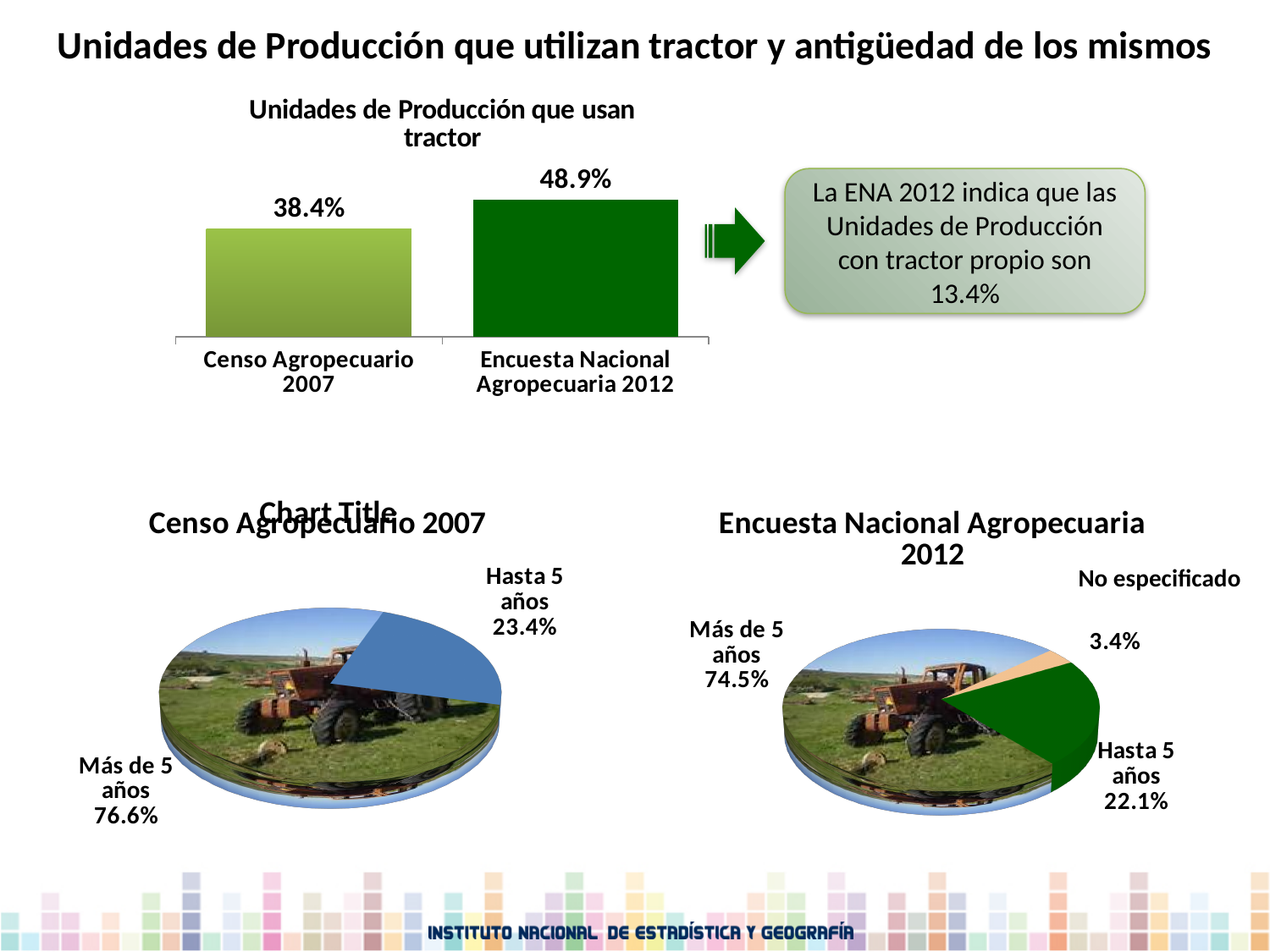
In the bar chart 'Unidades de Producción que usan tractor', what is the difference between the 2012 and 2007 values? 10.5% In the pie chart 'Encuesta Nacional Agropecuaria 2012', what share is 'No especificado'? 3.4% In the bar chart 'Unidades de Producción que usan tractor', which category has the higher value? Encuesta Nacional Agropecuaria 2012 In the pie chart 'Censo Agropecuario 2007', what share is 'Hasta 5 años'? 23.4% In the pie chart 'Encuesta Nacional Agropecuaria 2012', which slice is the largest? Más de 5 años In the bar chart 'Unidades de Producción que usan tractor', what is the value for Censo Agropecuario 2007? 38.4% How many slices does the pie chart 'Encuesta Nacional Agropecuaria 2012' have? 3 In the pie chart 'Encuesta Nacional Agropecuaria 2012', which slice is the smallest? No especificado In the bar chart 'Unidades de Producción que usan tractor', what is the value for Encuesta Nacional Agropecuaria 2012? 48.9% How many bars are in the bar chart 'Unidades de Producción que usan tractor'? 2 What type of chart is 'Unidades de Producción que usan tractor'? Bar chart In the pie chart 'Censo Agropecuario 2007', what share is 'Más de 5 años'? 76.6%